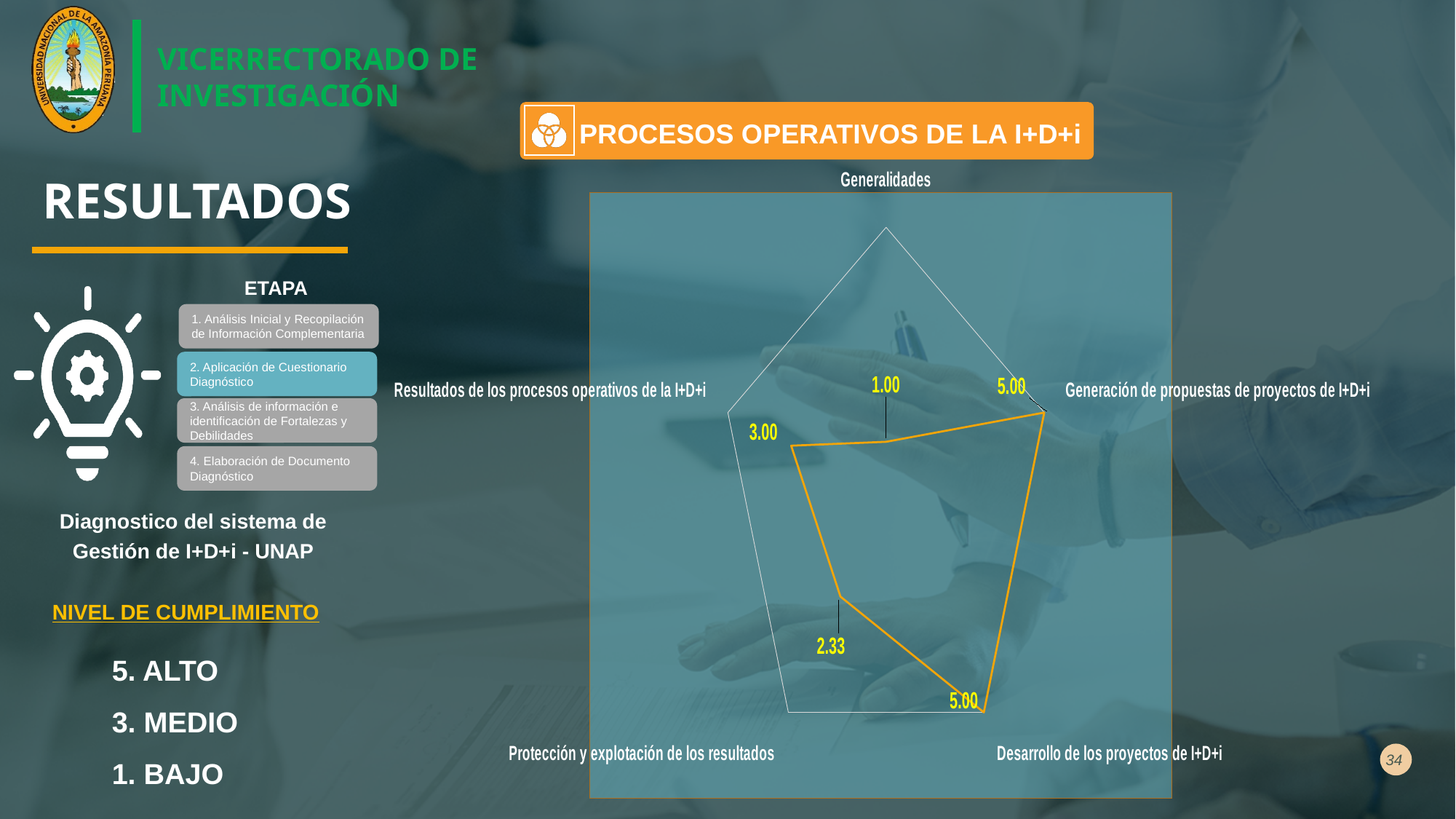
How many categories does the radar chart have? 5 What is the value for Resultados de los procesos operativos de la I+D+i? 3.00 What is the difference between the values for Desarrollo de los proyectos de I+D+i and Protección y explotación de los resultados? 2.67 What is the difference between the values for Resultados de los procesos operativos de la I+D+i and Generalidades? 2.00 What type of chart is shown on the slide? Radar chart Which is larger, the value for Protección y explotación de los resultados or the value for Resultados de los procesos operativos de la I+D+i? Resultados de los procesos operativos de la I+D+i What is the title shown above the chart? PROCESOS OPERATIVOS DE LA I+D+i What is the value for Desarrollo de los proyectos de I+D+i? 5.00 Which category has the lowest value? Generalidades What is the value for Protección y explotación de los resultados? 2.33 What is the value for Generación de propuestas de proyectos de I+D+i? 5.00 What is the value for Generalidades? 1.00